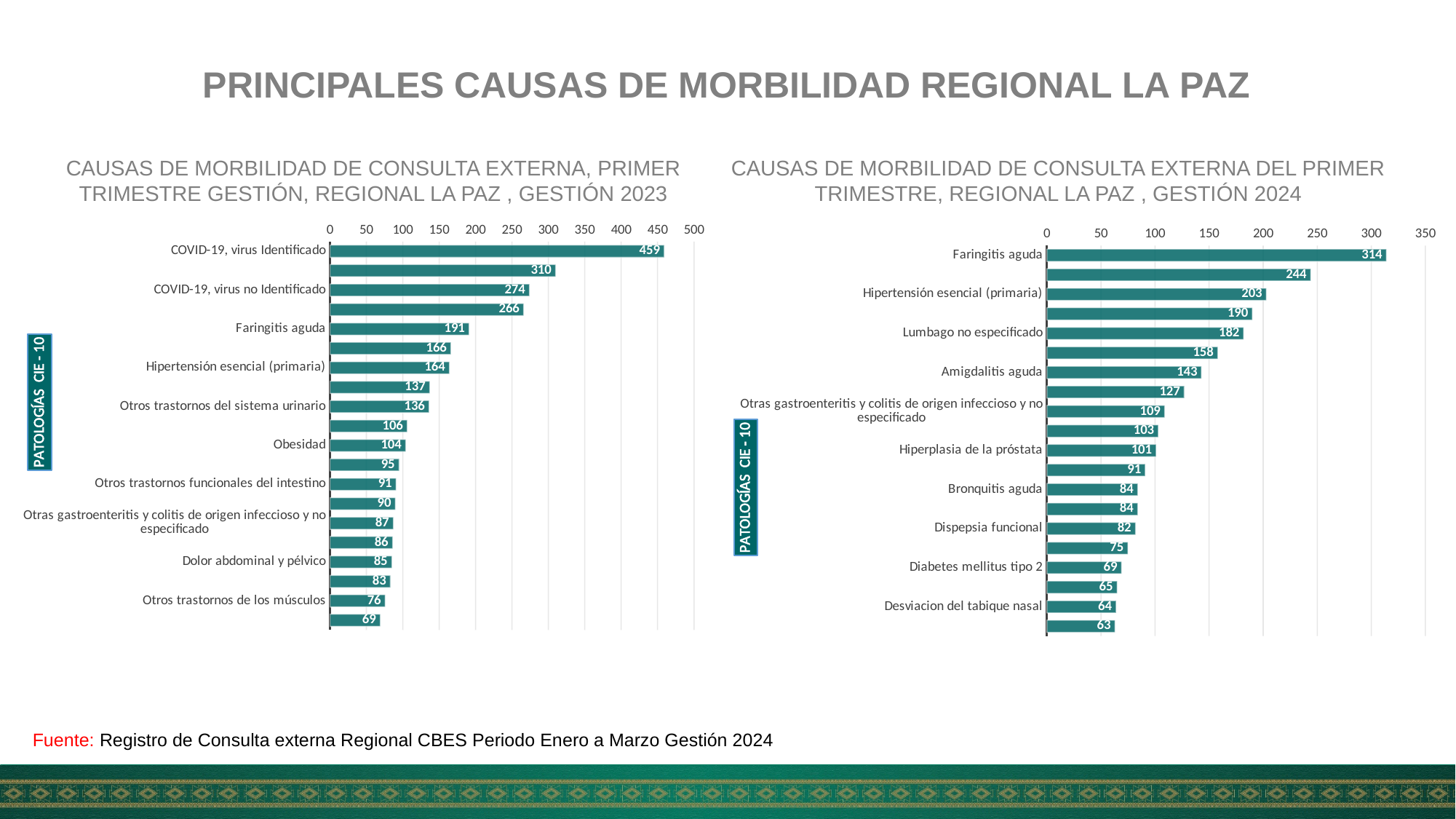
In the 2024 chart (right), what is the difference between Faringitis aguda and Hipertensión esencial (primaria)? 111 What kind of chart is the 2023 chart (left)? Bar chart In the 2023 chart (left), which category has the highest value? COVID-19, virus Identificado In the 2024 chart (right), which category has the highest value? Faringitis aguda In the 2024 chart (right), what is the value for Lumbago no especificado? 182 In the 2024 chart (right), which is larger: Amigdalitis aguda or Hiperplasia de la próstata? Amigdalitis aguda How many bars are plotted in the 2024 chart (right)? 20 In the 2023 chart (left), what is the value for Hipertensión esencial (primaria)? 164 In the 2023 chart (left), is the value for Faringitis aguda greater or less than 150? greater In the 2024 chart (right), what is the value for Faringitis aguda? 314 In the 2023 chart (left), what is the value for COVID-19, virus Identificado? 459 In the 2023 chart (left), what is the difference between COVID-19, virus Identificado and COVID-19, virus no Identificado? 185